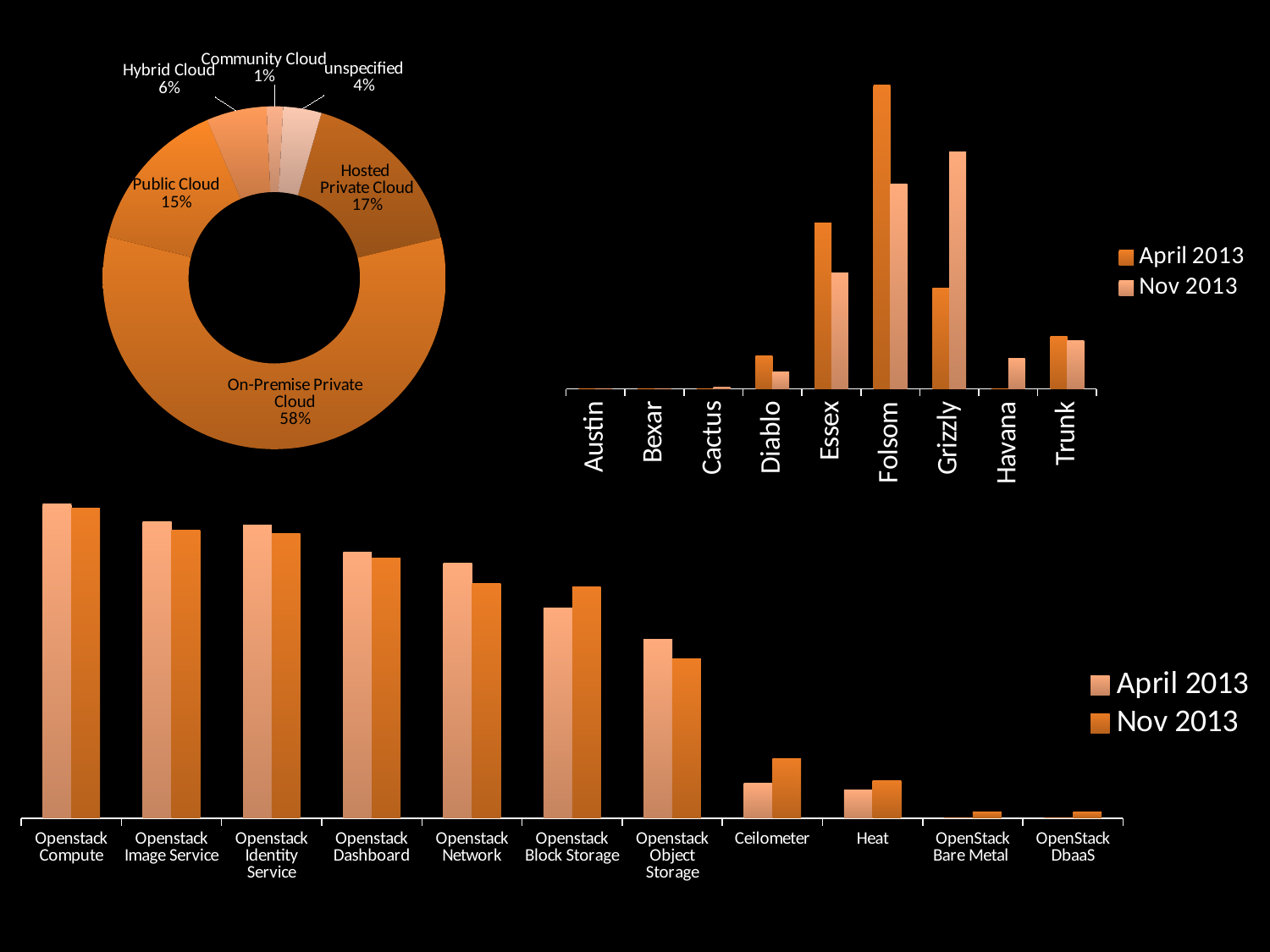
In the doughnut chart at the top left, which category has the smallest share? Community Cloud In the bar chart at the bottom, is the Ceilometer value larger for April 2013 or Nov 2013? Nov 2013 In the doughnut chart at the top left, how many categories are shown? 6 In the bar chart at the top right, which category has the highest April 2013 value? Folsom In the bar chart at the top right, is the Grizzly value larger for April 2013 or Nov 2013? Nov 2013 In the doughnut chart at the top left, what percentage is shown for Hosted Private Cloud? 17% In the doughnut chart at the top left, what is the difference between the Public Cloud and Hybrid Cloud shares? 9% In the bar chart at the top right, how many categories are shown on the x axis? 9 In the bar chart at the bottom, how many series does the legend list? 2 In the doughnut chart at the top left, what share is On-Premise Private Cloud? 58% In the bar chart at the top right, is the Essex value larger for April 2013 or Nov 2013? April 2013 In the bar chart at the bottom, which category has the highest values? Openstack Compute